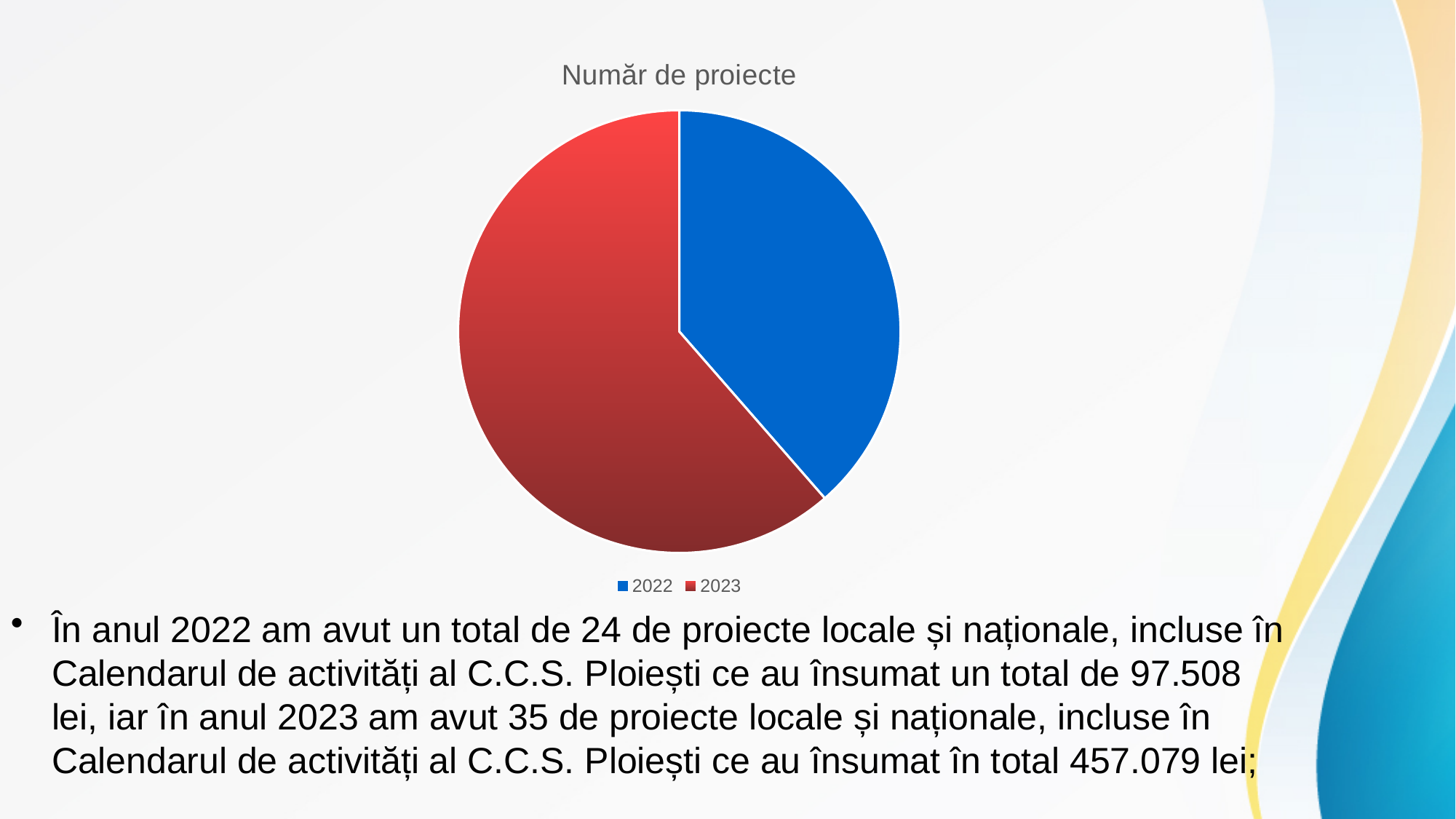
How many entries does the legend list? 2 Which year has the larger slice of the pie? 2023 Which colour represents 2022 in the pie chart? blue Which year has the smaller slice of the pie? 2022 What kind of chart is shown on the slide? pie chart How many slices does the pie chart have? 2 Does the 2023 slice take up more or less than half of the pie? more What is the title of the chart? Număr de proiecte Is the slice for 2022 larger or smaller than the slice for 2023? smaller